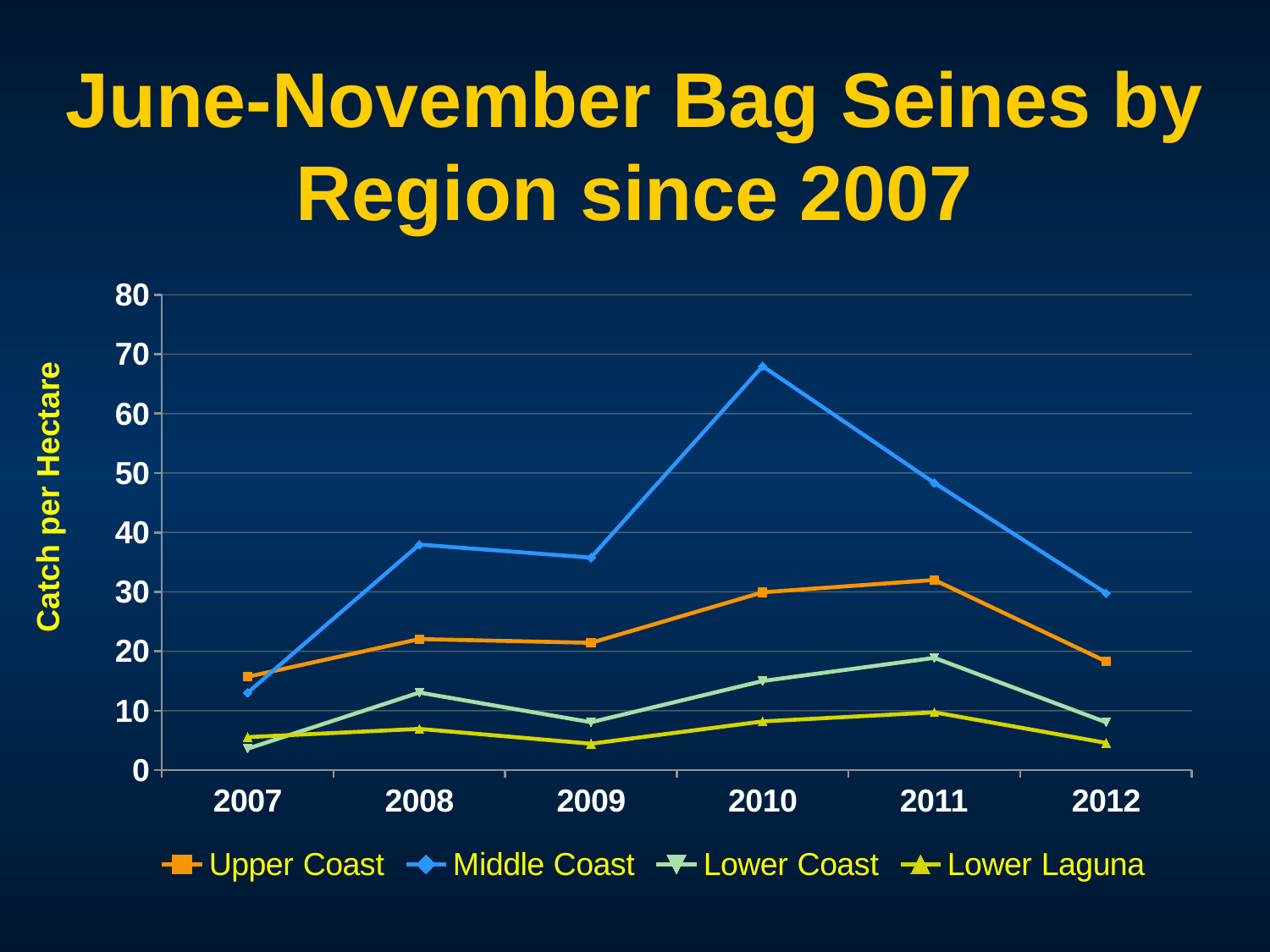
How many years are plotted along the x axis? 6 Which series has the higher value in 2010, Middle Coast or Upper Coast? Middle Coast Which series has the highest value in 2011? Middle Coast Is the Middle Coast value for 2010 greater or less than 60? greater In which year is the Middle Coast value lowest? 2007 Is the Upper Coast value for 2010 greater or less than 40? less What kind of chart is shown on the slide? Line chart Does the Middle Coast series rise or fall from 2010 to 2012? Fall What is the label on the y axis? Catch per Hectare Is the Lower Coast value for 2011 greater or less than 10? greater How many series does the legend list? 4 In which year does the Middle Coast series reach its highest value? 2010